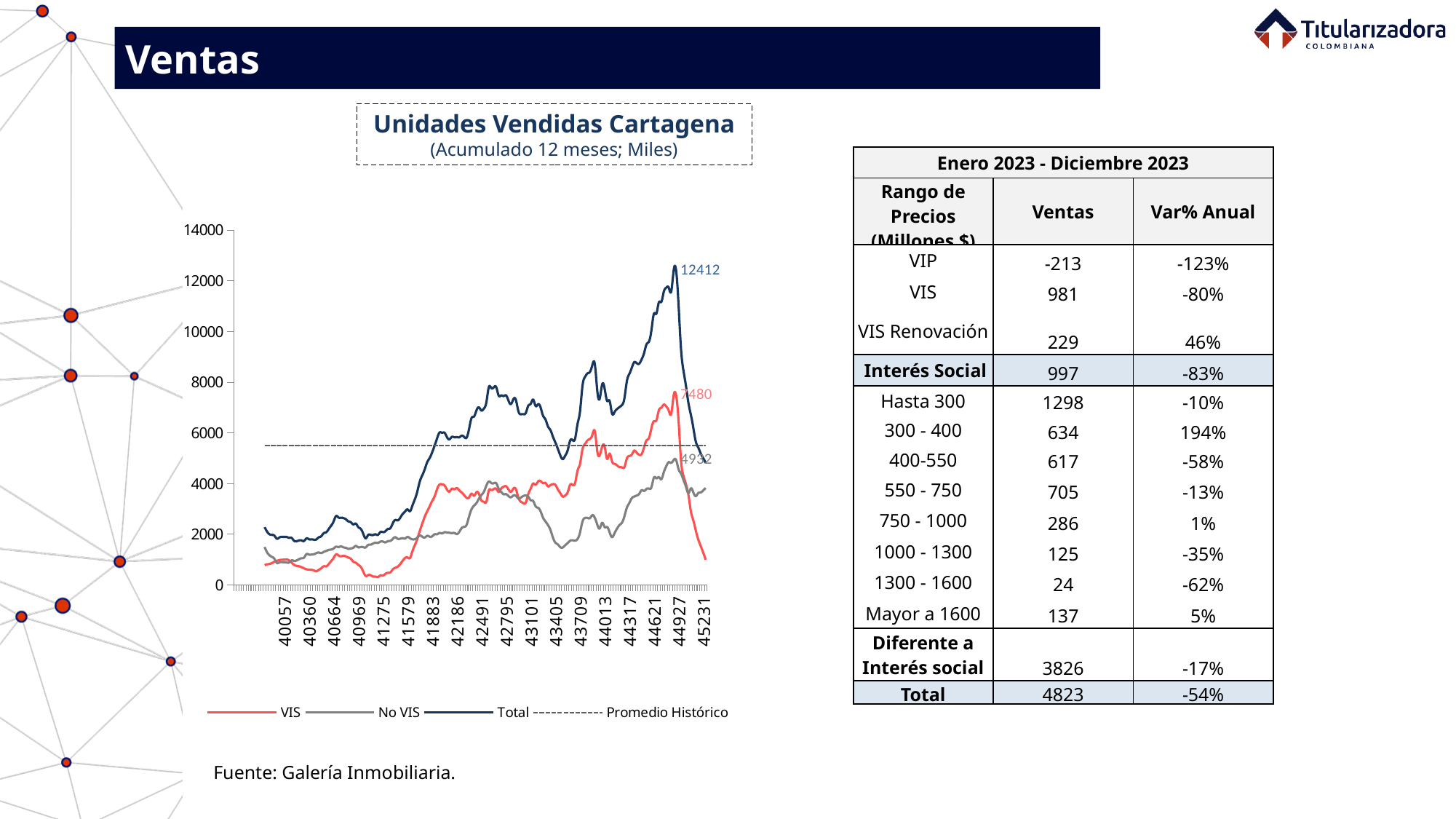
What is the difference between the labelled Total value (12412) and the labelled VIS value (7480)? 4932 Which labelled value is larger, VIS (7480) or No VIS (4932)? VIS Which series has the lowest labelled value on the chart? No VIS What kind of chart is shown on the slide? line chart What is the title of the chart? Unidades Vendidas Cartagena What is the labelled peak value of the VIS series? 7480 What is the labelled peak value of the Total series? 12412 Is the Promedio Histórico dashed line greater or less than 6000? less What is the labelled peak value of the No VIS series? 4932 How many series does the chart legend list? 4 Which series has the highest labelled value on the chart? Total Is the value of the VIS series at the last point (45231) greater or less than 2000? less